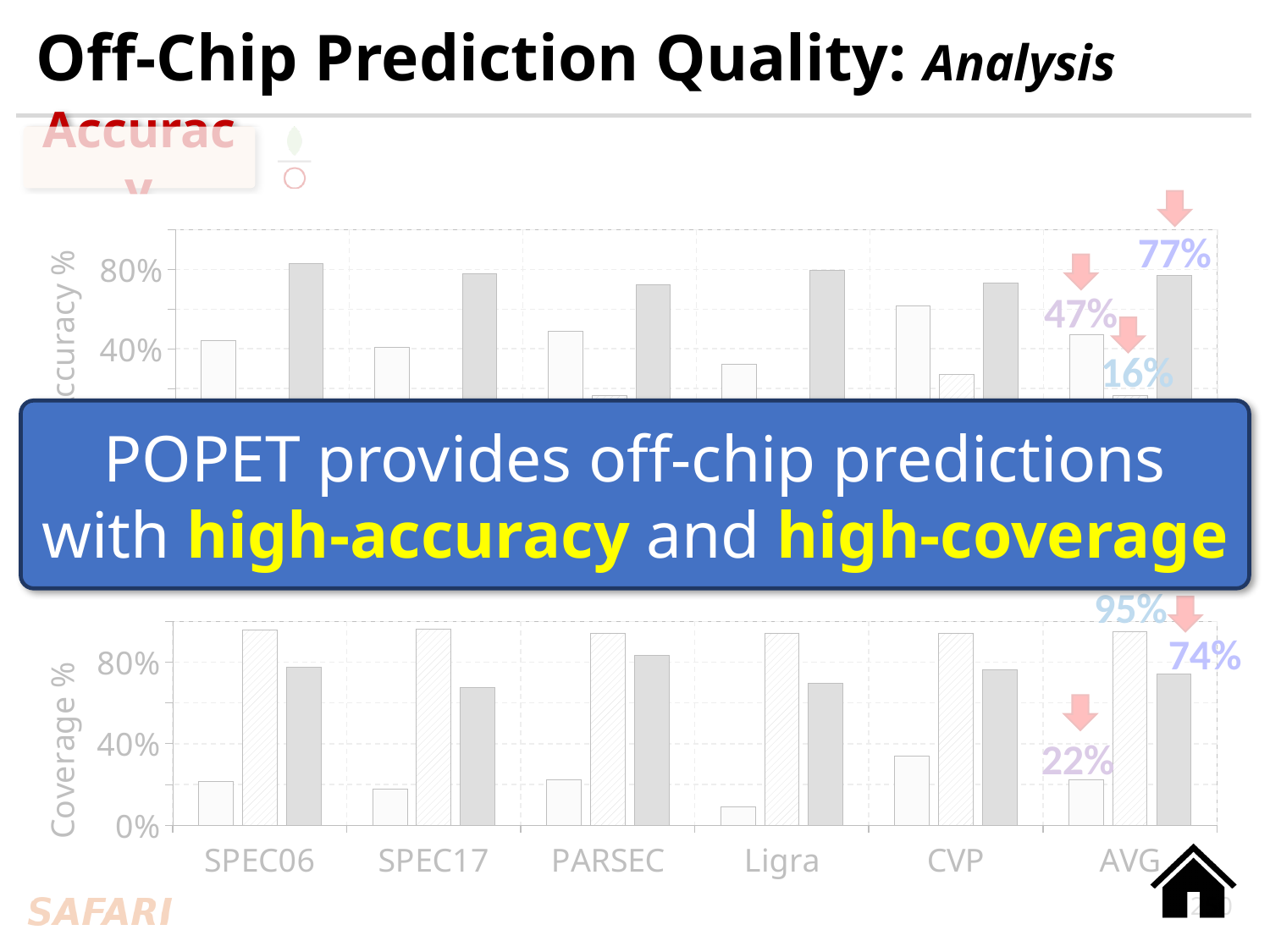
In the Coverage % chart, what is the labelled value of the solid grey bar for AVG? 74% In the Coverage % chart, what is the labelled value of the hatched bar for AVG? 95% In the Accuracy % chart, what is the labelled value of the first (white) bar for AVG? 47% In the Accuracy % chart, what is the labelled value of the solid grey bar for AVG? 77% How many categories are shown along the x axis of the Coverage % chart? 6 In the Coverage % chart, is the value of the grey bar for SPEC06 greater or less than 40%? greater What kind of chart is the Coverage % chart at the bottom of the slide? bar chart In the Coverage % chart, what is the difference between the hatched bar (95%) and the grey bar (74%) for AVG? 21% In the Coverage % chart, which of the three AVG bars is the highest? the hatched bar (95%) In the Accuracy % chart, what is the difference between the grey bar (77%) and the white bar (47%) for AVG? 30% In the Coverage % chart, what is the labelled value of the first (white) bar for AVG? 22% In the Accuracy % chart, what is the labelled value of the hatched bar for AVG? 16%